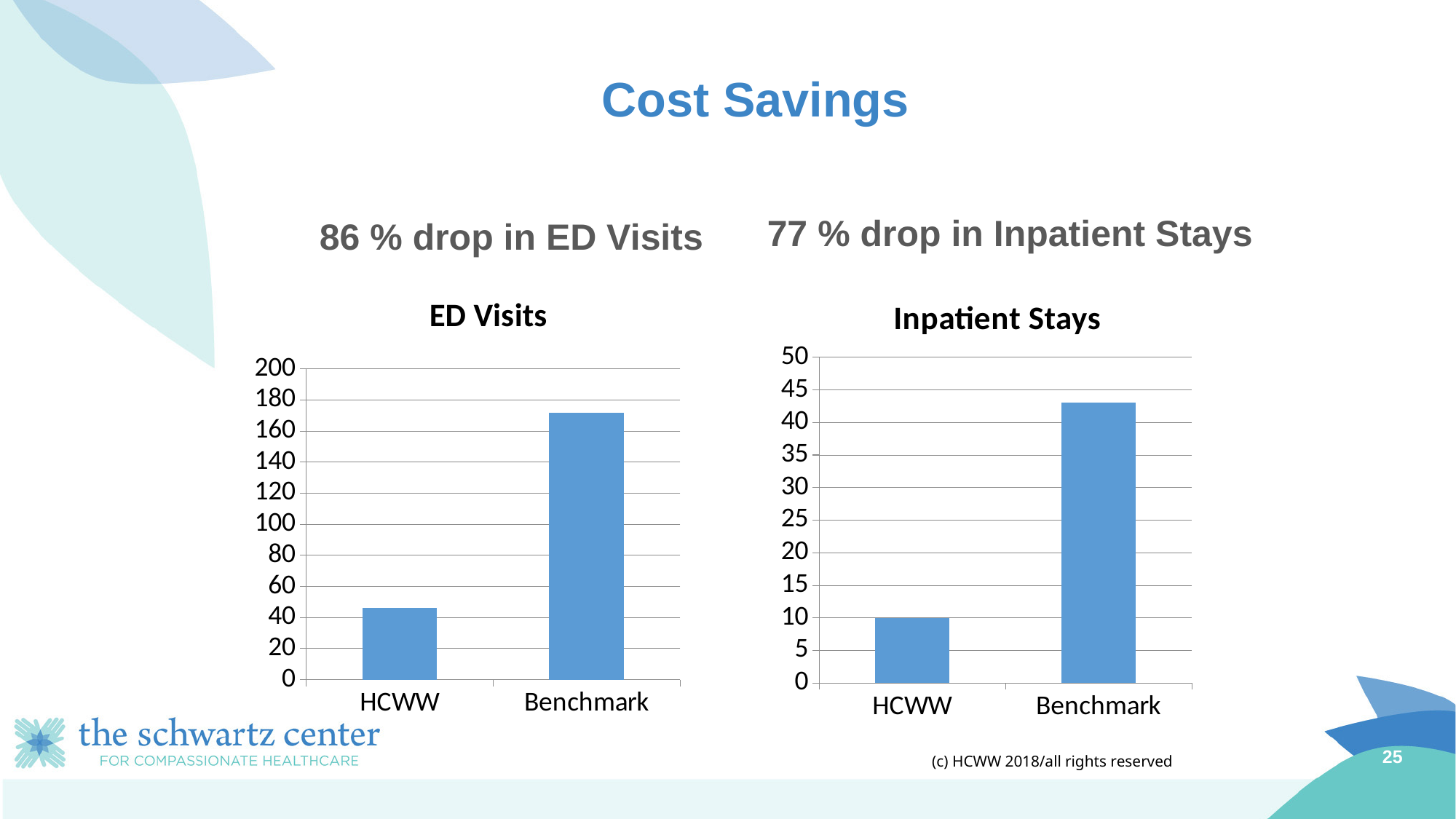
In the ED Visits chart, is the value for HCWW greater or less than 60? less In the Inpatient Stays chart, is the value for HCWW larger or smaller than the value for Benchmark? smaller How many categories are shown in the Inpatient Stays chart? 2 In the ED Visits chart, is the value for Benchmark greater or less than 160? greater What is the title of the chart on the right side of the slide? Inpatient Stays In the Inpatient Stays chart, what is the value for HCWW? 10 In the Inpatient Stays chart, which category has the lowest value? HCWW In the ED Visits chart, which category has the higher value? Benchmark In the Inpatient Stays chart, is the value for Benchmark greater or less than 40? greater What type of chart is the ED Visits chart? bar chart